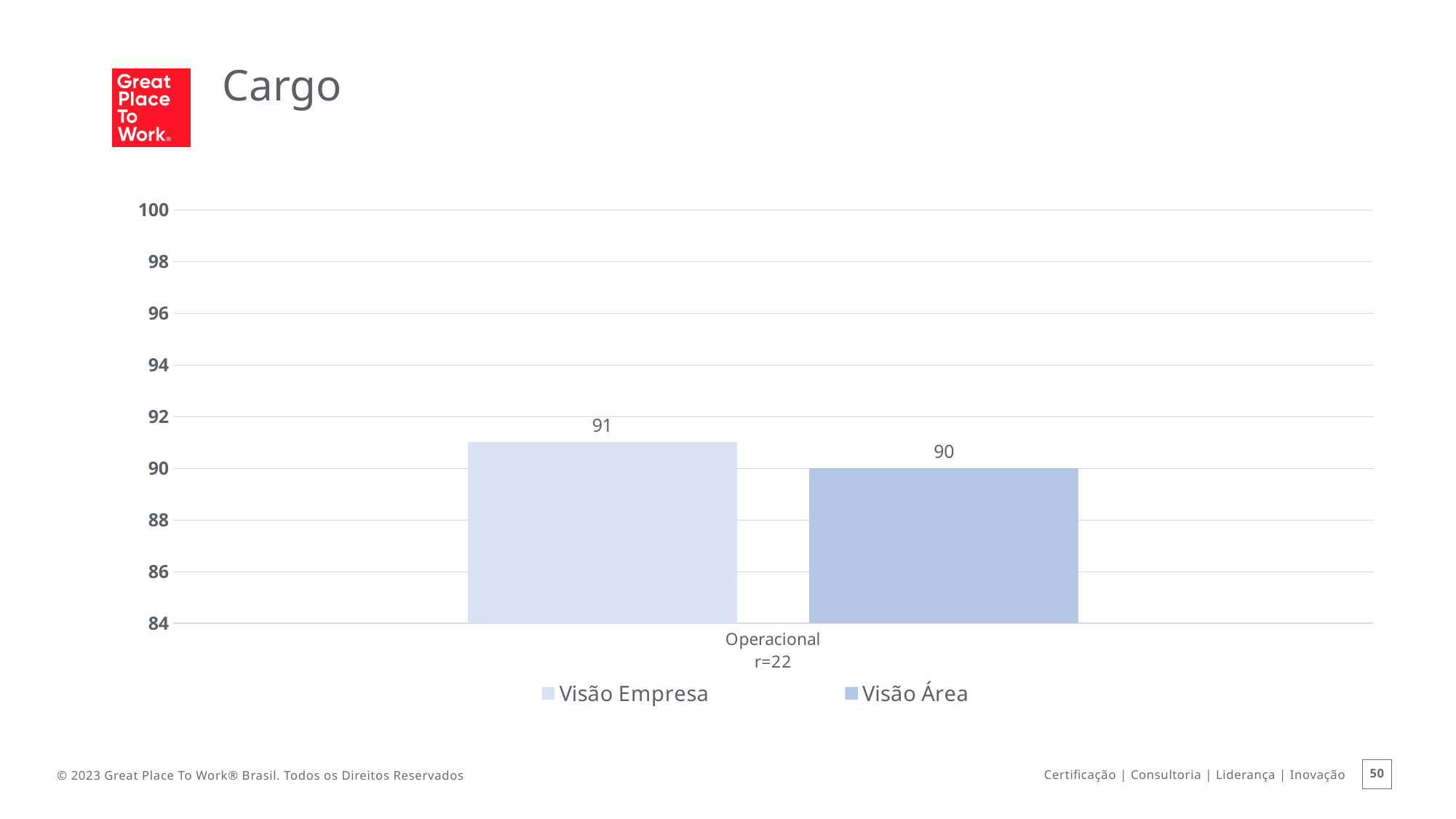
Is the value for Visão Empresa for Operacional greater or less than 92? less Which series has the higher value for Operacional, Visão Empresa or Visão Área? Visão Empresa What is the difference between the Visão Empresa and Visão Área values for Operacional? 1 What is the category label shown on the x axis? Operacional r=22 Is the value for Visão Área for Operacional greater or less than 88? greater What is the highest value shown on the y axis? 100 How many series does the legend list? 2 What kind of chart is shown on the slide? bar chart What is the title of the slide? Cargo What is the value for Visão Empresa for Operacional? 91 How many categories are shown on the x axis? 1 What is the value for Visão Área for Operacional? 90